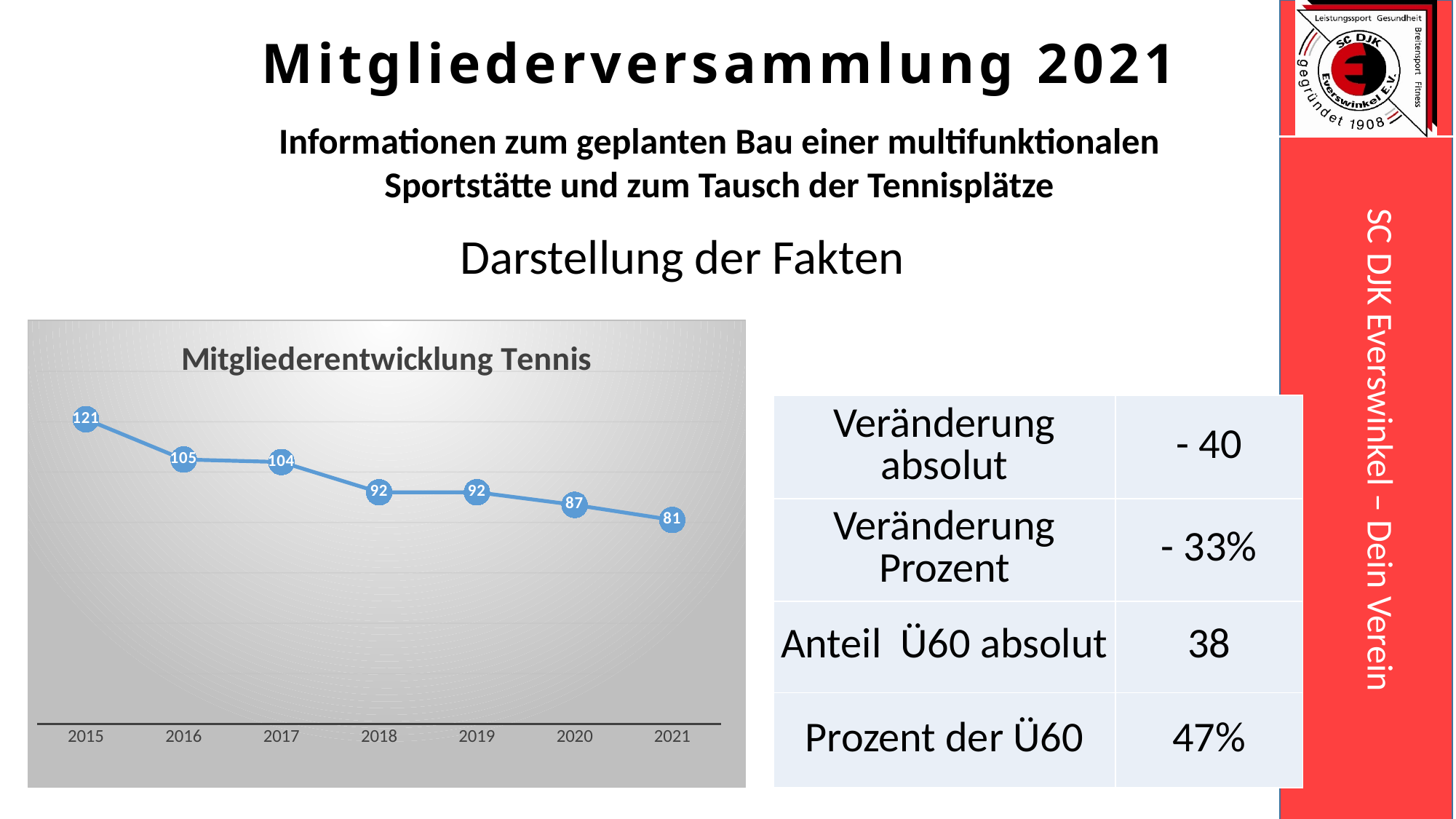
Which year has the highest value in the Mitgliederentwicklung Tennis chart? 2015 What is the difference between the values for 2015 and 2021 in the Mitgliederentwicklung Tennis chart? 40 What is the difference between the values for 2016 and 2017 in the Mitgliederentwicklung Tennis chart? 1 What is the value for 2021 in the Mitgliederentwicklung Tennis chart? 81 What is the value for 2018 in the Mitgliederentwicklung Tennis chart? 92 What is the value for 2020 in the Mitgliederentwicklung Tennis chart? 87 Do the values in the Mitgliederentwicklung Tennis chart generally rise or fall from 2015 to 2021? fall Which is larger in the Mitgliederentwicklung Tennis chart, the value for 2016 or the value for 2019? 2016 What is the value for 2015 in the Mitgliederentwicklung Tennis chart? 121 How many data points are plotted in the Mitgliederentwicklung Tennis chart? 7 What kind of chart is the Mitgliederentwicklung Tennis chart? line chart Which year has the lowest value in the Mitgliederentwicklung Tennis chart? 2021